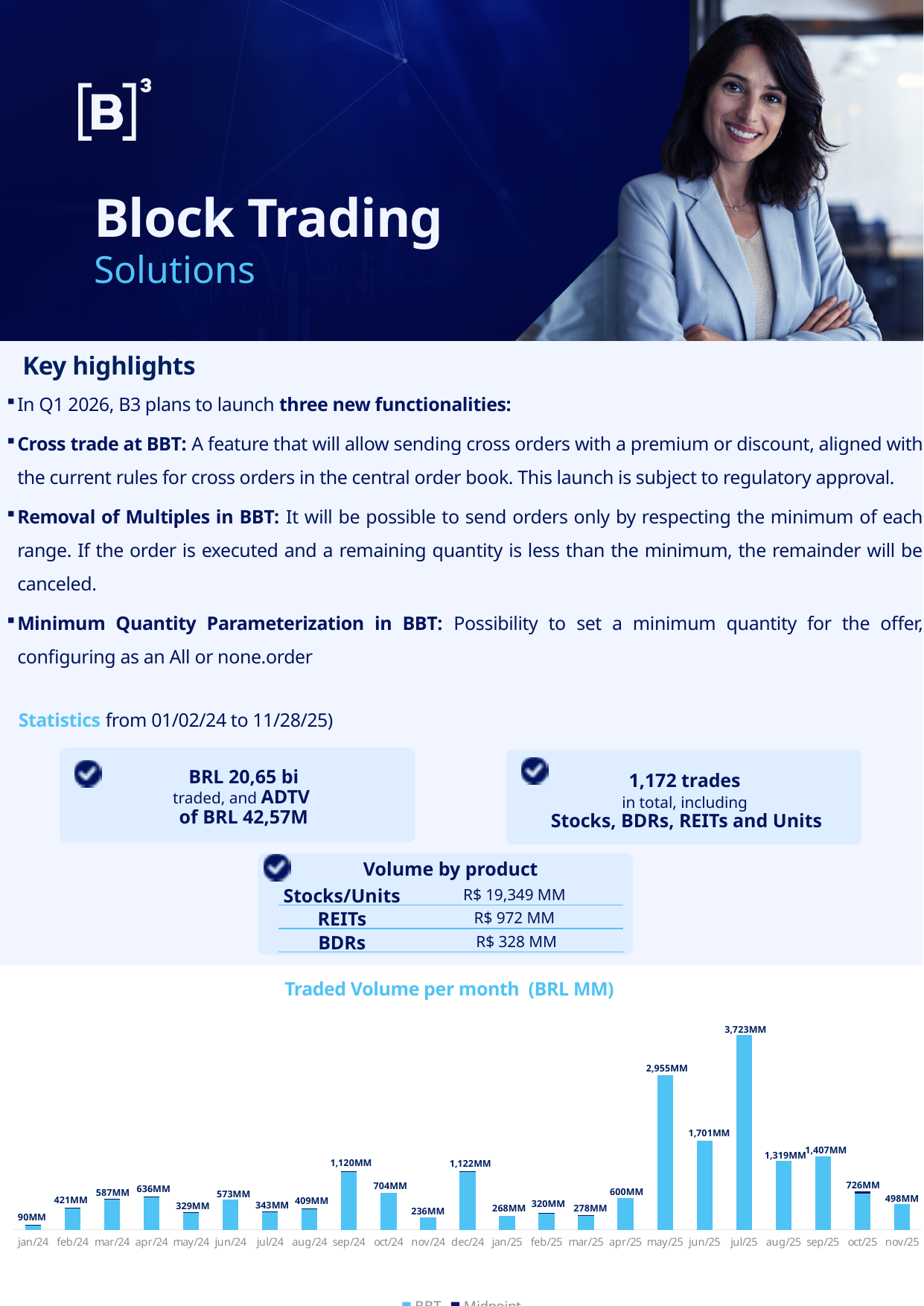
Which month has the highest traded volume in the 'Traded Volume per month' chart? jul/25 In the 'Traded Volume per month' chart, what is the difference between the values for jun/25 and aug/25? 382MM How many months are shown on the x axis of the 'Traded Volume per month' chart? 23 What is the title of the bar chart at the bottom of the slide? Traded Volume per month (BRL MM) In the 'Traded Volume per month' chart, what is the difference between the values for jul/25 and may/25? 768MM Which month has the lowest traded volume in the 'Traded Volume per month' chart? jan/24 What type of chart is 'Traded Volume per month (BRL MM)'? bar chart In the 'Traded Volume per month' chart, what is the value for may/25? 2,955MM In the 'Traded Volume per month' chart, what is the value for nov/25? 498MM In the 'Traded Volume per month' chart, which is larger: the value for sep/24 or the value for dec/24? dec/24 In the 'Traded Volume per month' chart, what is the value for jul/25? 3,723MM In the 'Traded Volume per month' chart, what is the value for jan/24? 90MM